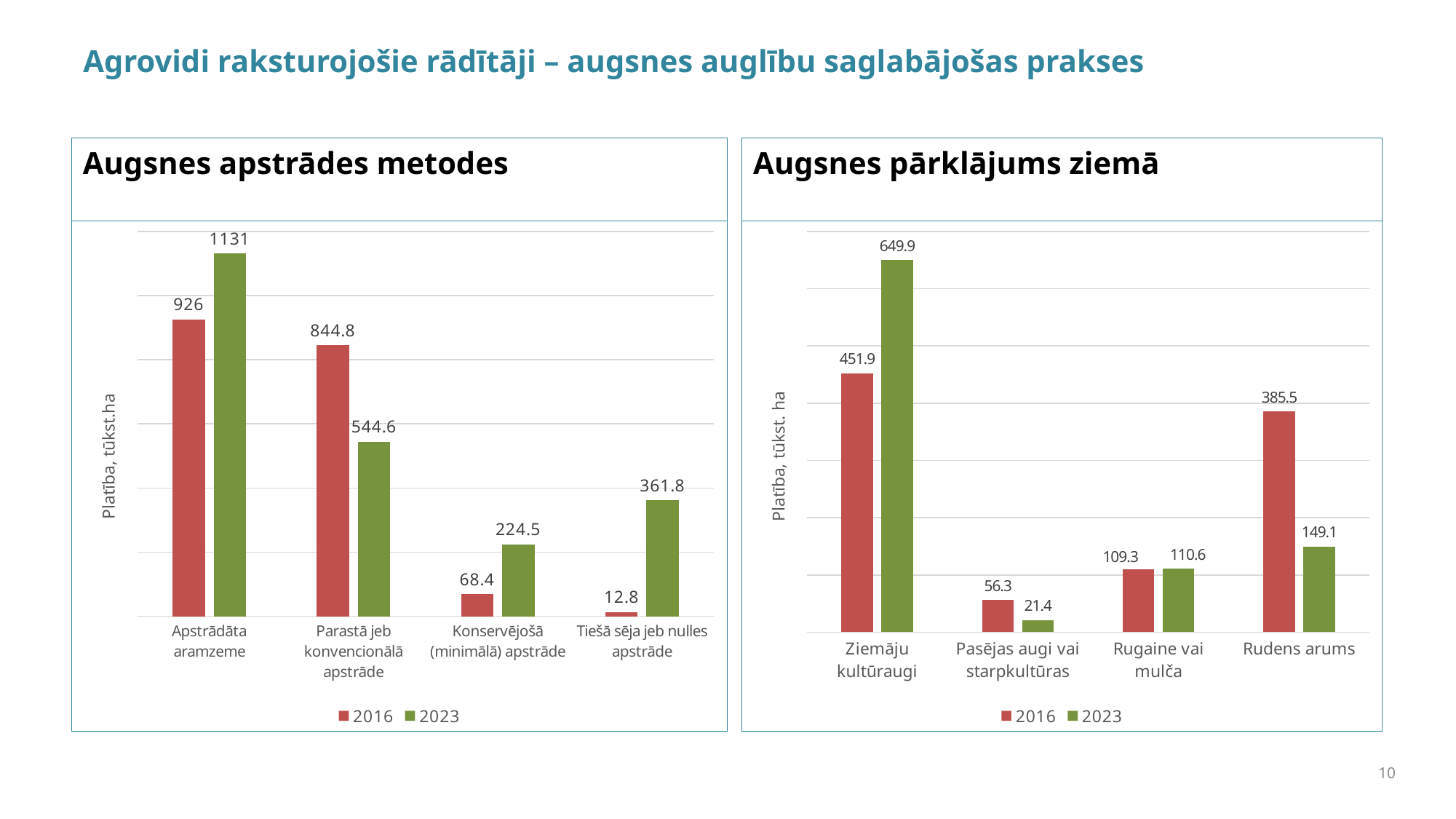
In the 'Augsnes apstrādes metodes' chart, what is the 2023 value for Apstrādāta aramzeme? 1131 In the 'Augsnes pārklājums ziemā' chart, which category has the highest 2016 value? Ziemāju kultūraugi In the 'Augsnes apstrādes metodes' chart, what is the 2016 value for Tiešā sēja jeb nulles apstrāde? 12.8 In the 'Augsnes pārklājums ziemā' chart, what is the 2023 value for Ziemāju kultūraugi? 649.9 In the 'Augsnes apstrādes metodes' chart, what is the difference between the 2016 and 2023 values for Parastā jeb konvencionālā apstrāde? 300.2 What kind of chart is 'Augsnes apstrādes metodes'? Bar chart In the 'Augsnes pārklājums ziemā' chart, what is the difference between the 2016 and 2023 values for Rudens arums? 236.4 In the 'Augsnes apstrādes metodes' chart, how many categories are shown on the x axis? 4 How many series does the legend of the 'Augsnes pārklājums ziemā' chart list? 2 In the 'Augsnes apstrādes metodes' chart, which category has the lowest 2023 value? Konservējošā (minimālā) apstrāde In the 'Augsnes pārklājums ziemā' chart, what is the 2016 value for Rudens arums? 385.5 In the 'Augsnes pārklājums ziemā' chart, which is larger for Pasējas augi vai starpkultūras: the 2016 value or the 2023 value? 2016